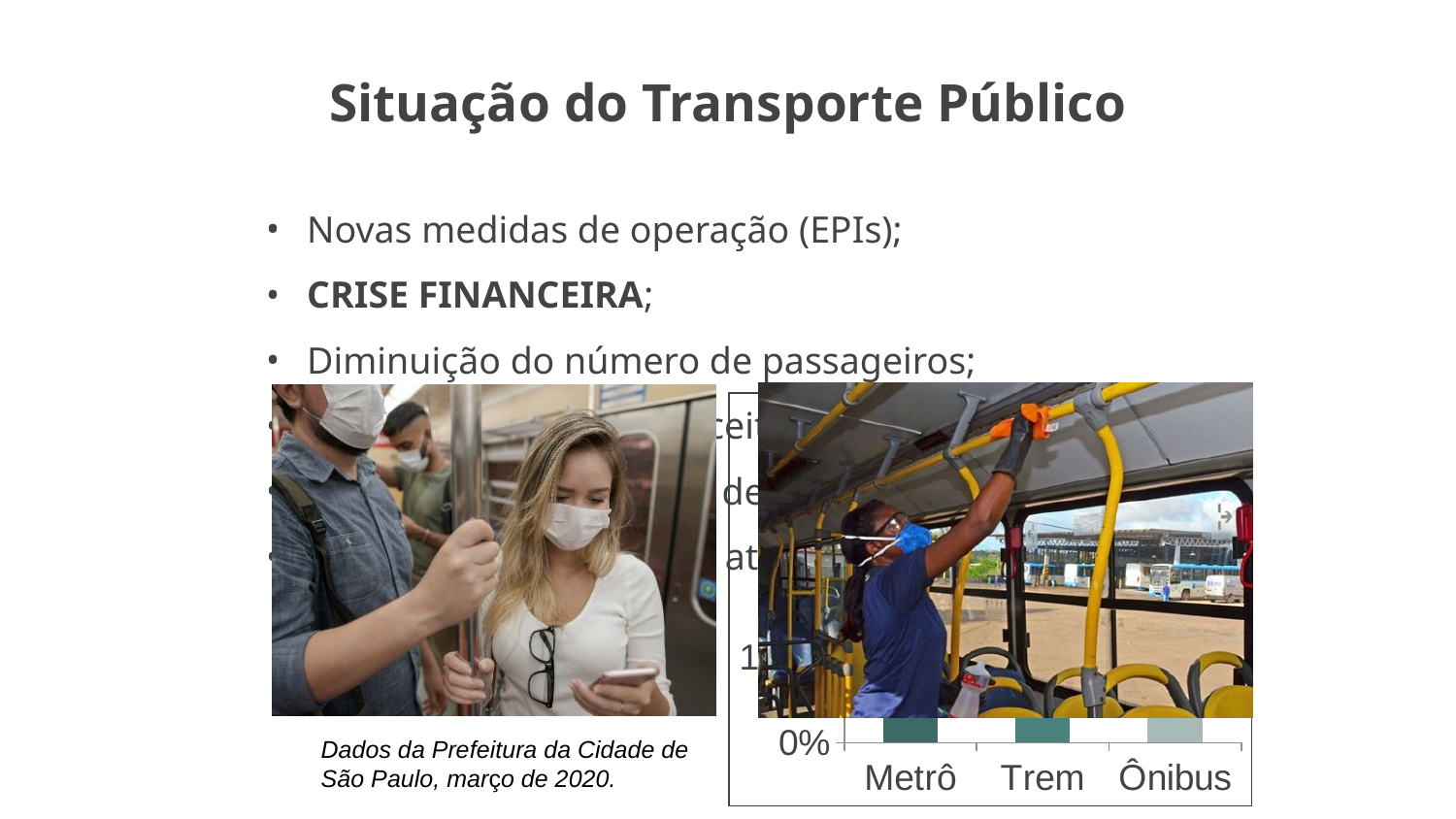
What is the lowest tick label shown on the y axis of the chart? 0% Which category is listed last on the x axis of the chart? Ônibus How many categories are shown on the x axis of the chart? 3 Which category is listed first on the x axis of the chart? Metrô What are the category labels on the x axis of the chart? Metrô, Trem, Ônibus What kind of chart is shown on the slide? bar chart